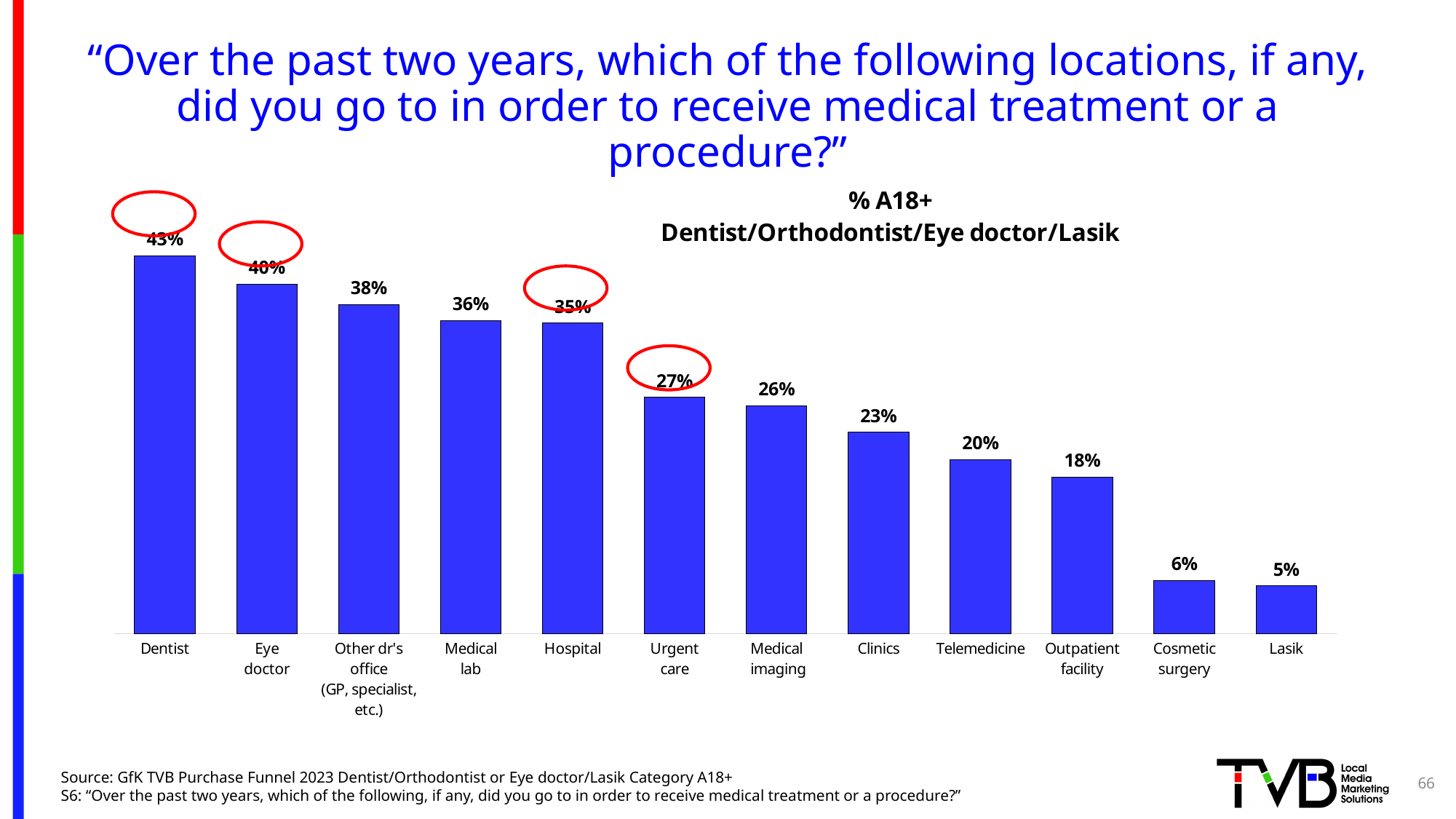
Which is larger, the value for Clinics or the value for Outpatient facility? Clinics Which location has the highest percentage? Dentist Which location has the lowest percentage? Lasik What is the difference between the Hospital and Urgent care values? 8% Do the values rise or fall moving from left to right across the chart? Fall What is the difference between the Dentist and Eye doctor percentages? 3% What is the subtitle shown above the chart? % A18+ Dentist/Orthodontist/Eye doctor/Lasik What percentage of A18+ went to a Dentist? 43% What percentage is shown for Medical imaging? 26% How many locations are shown on the chart? 12 What kind of chart is shown on the slide? Bar chart What is the value shown for Telemedicine? 20%